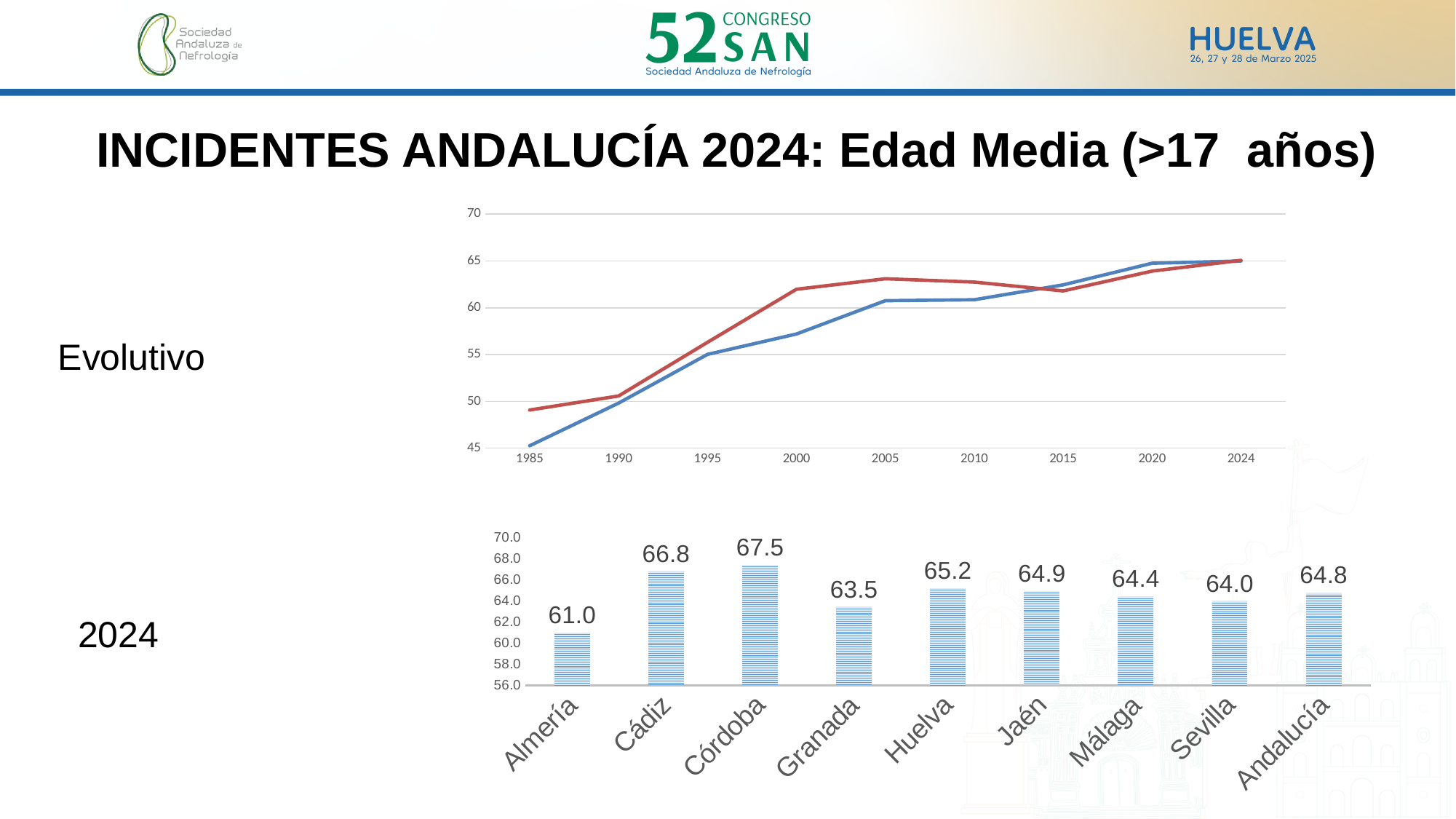
On the top line chart (Evolutivo), do the values generally rise or fall from 1985 to 2024? rise On the top line chart (Evolutivo), is the value of the red line in 2000 greater or less than 60? greater What kind of chart is the bottom chart (2024)? Bar chart What kind of chart is the top chart (Evolutivo)? Line chart On the bottom bar chart (2024), which category has the highest value? Córdoba On the bottom bar chart (2024), what is the value for Córdoba? 67.5 On the bottom bar chart (2024), what is the value for Andalucía? 64.8 On the bottom bar chart (2024), which is larger, the value for Huelva or the value for Granada? Huelva On the top line chart (Evolutivo), is the value of the blue line in 1985 greater or less than 50? less On the bottom bar chart (2024), which category has the lowest value? Almería On the bottom bar chart (2024), what is the difference between the values for Cádiz and Almería? 5.8 On the bottom bar chart (2024), how many categories are shown? 9